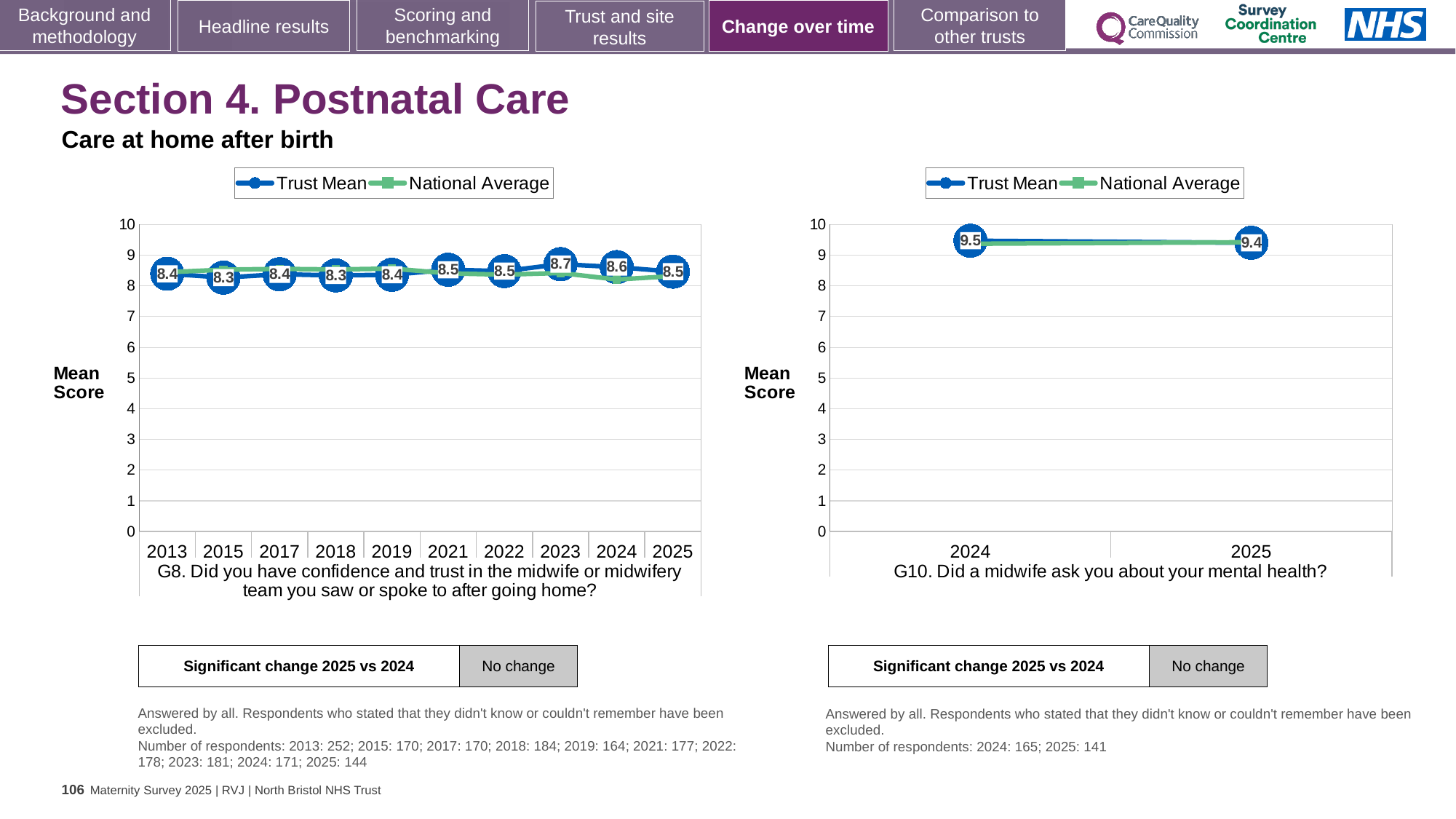
What type of chart is the G8 chart? Line chart In the G8 chart, is the Trust Mean for 2024 greater or less than 8? greater In the G8 chart, how many years are shown on the x axis? 10 In the G10 chart, does the Trust Mean rise or fall from 2024 to 2025? Fall In the G10 chart, what is the Trust Mean for 2024? 9.5 In the G8 chart, what is the difference between the Trust Mean in 2023 and in 2025? 0.2 In the G8 chart, which year has the highest Trust Mean? 2023 In the G8 chart, how many series does the legend list? 2 In the G10 chart, what is the difference between the Trust Mean in 2024 and in 2025? 0.1 In the G8 chart, what is the Trust Mean for 2015? 8.3 In the G8 chart, what is the Trust Mean for 2023? 8.7 In the G10 chart, what is the Trust Mean for 2025? 9.4